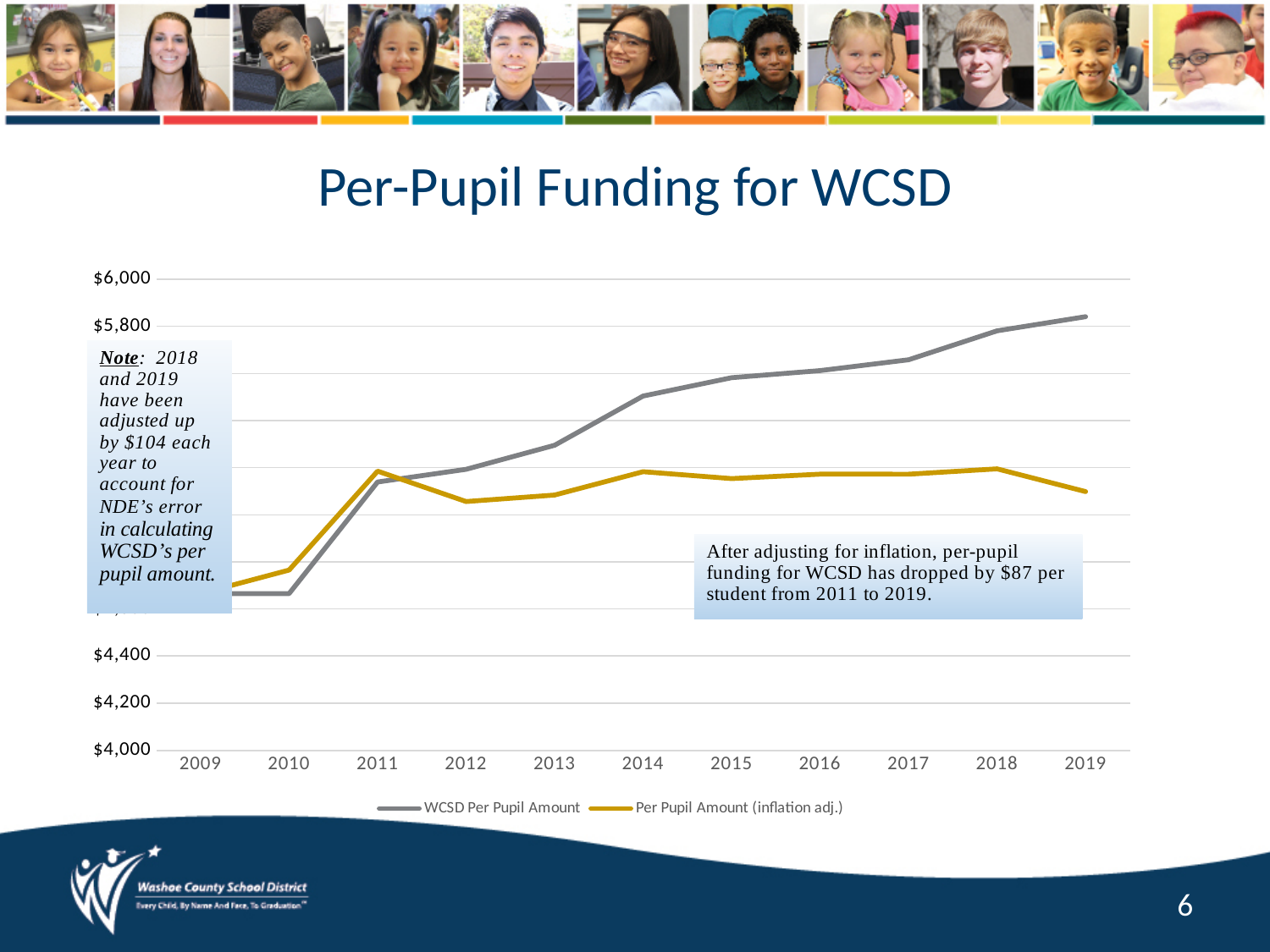
In 2019, which series has the higher value, WCSD Per Pupil Amount or Per Pupil Amount (inflation adj.)? WCSD Per Pupil Amount In which year is the Per Pupil Amount (inflation adj.) lowest? 2009 How many series does the legend list? 2 Is the Per Pupil Amount (inflation adj.) for 2019 greater or less than $6,000? less In 2016, which series has the higher value, WCSD Per Pupil Amount or Per Pupil Amount (inflation adj.)? WCSD Per Pupil Amount Does the WCSD Per Pupil Amount generally rise or fall from 2009 to 2019? rise What is the title of the chart? Per-Pupil Funding for WCSD Is the WCSD Per Pupil Amount for 2009 greater or less than $4,400? greater How many years are plotted along the x axis? 11 What kind of chart is shown on the slide? line chart Which series is drawn in gold? Per Pupil Amount (inflation adj.) In which year is the WCSD Per Pupil Amount highest? 2019